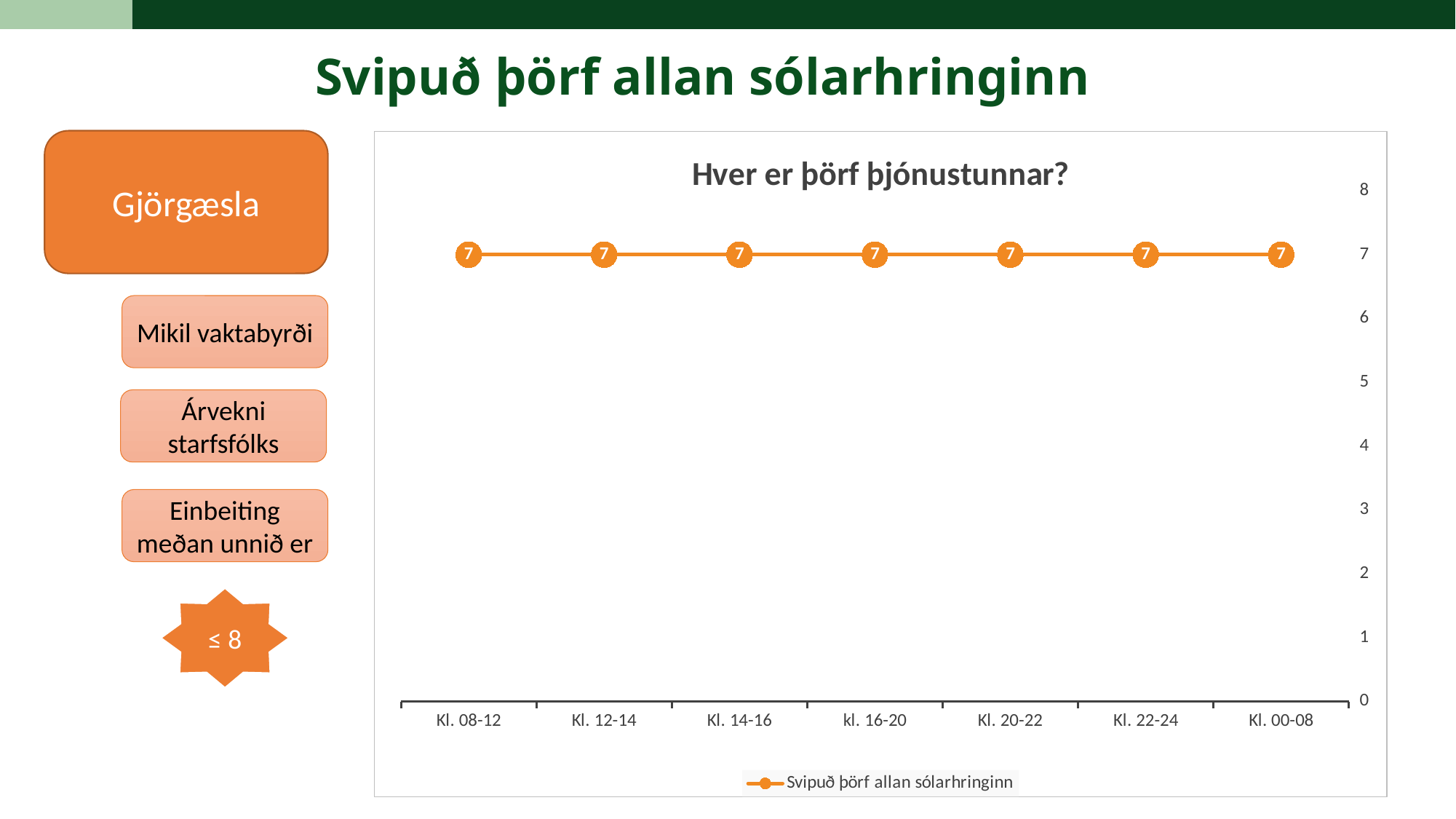
What is the value for Kl. 00-08? 7 What is the difference between the values for Kl. 12-14 and Kl. 22-24? 0 Do the values rise, fall or stay flat from Kl. 08-12 to Kl. 00-08? stay flat How many time periods are plotted on the x axis? 7 What is the title of the chart? Hver er þörf þjónustunnar? What is the name of the series in the legend? Svipuð þörf allan sólarhringinn How many series does the legend list? 1 What is the value for kl. 16-20? 7 What kind of chart is shown? line chart Is the value for Kl. 20-22 greater or less than 5? greater What is the highest value shown on the y axis? 8 What is the value for Kl. 08-12? 7